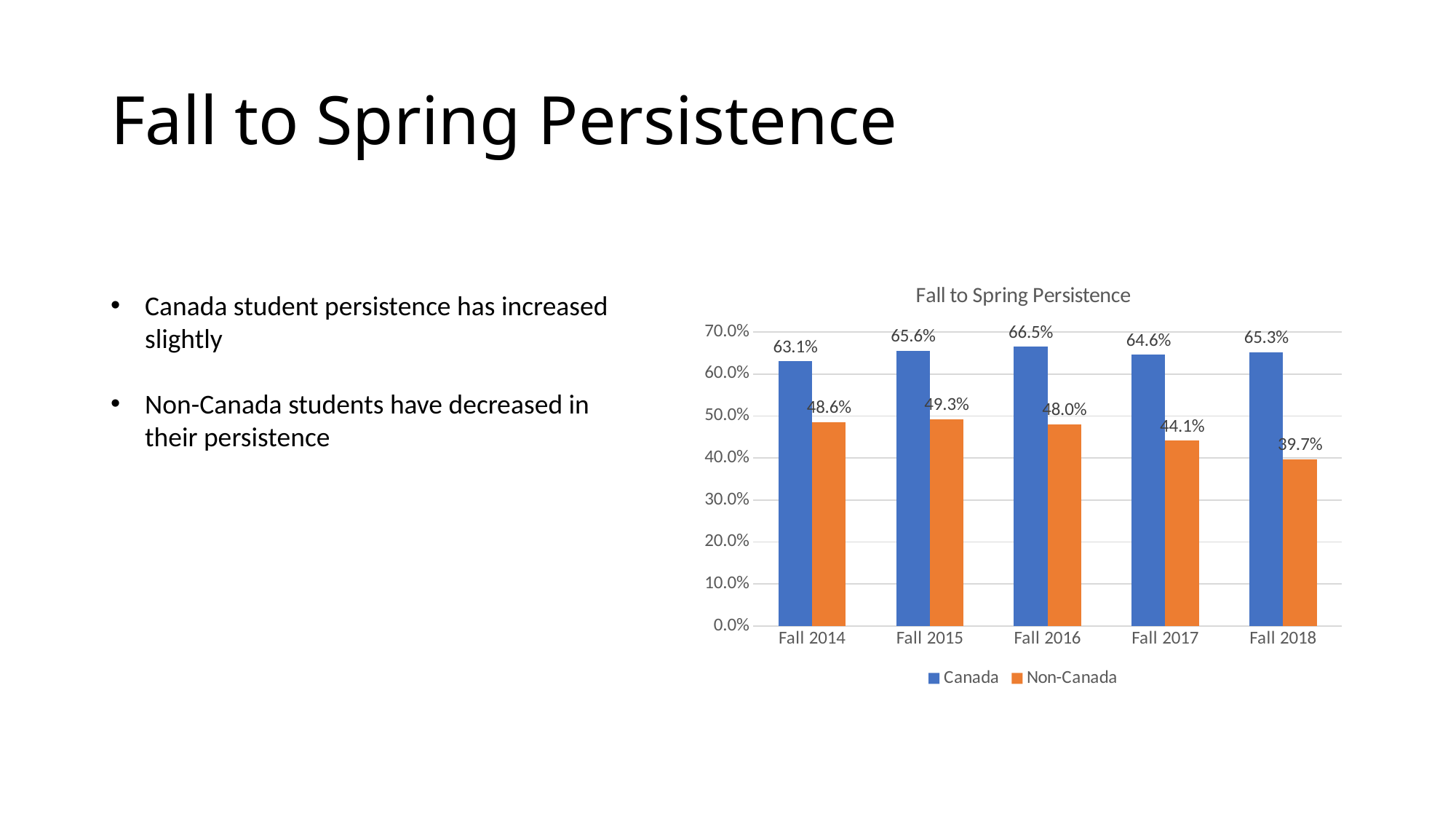
What is the Non-Canada value for Fall 2015? 49.3% In which term is the Canada persistence highest? Fall 2016 What is the difference between the Canada and Non-Canada values in Fall 2018? 25.6% How many series does the legend list? 2 Does the Non-Canada persistence rise or fall from Fall 2015 to Fall 2018? fall Is the Non-Canada value for Fall 2017 greater or less than 50.0%? less In which term is the Non-Canada persistence lowest? Fall 2018 What is the Non-Canada persistence value for Fall 2018? 39.7% What kind of chart is shown? bar chart Which is larger: the Non-Canada value for Fall 2014 or for Fall 2017? Fall 2014 How many terms are shown on the x axis? 5 What is the Canada persistence value for Fall 2016? 66.5%